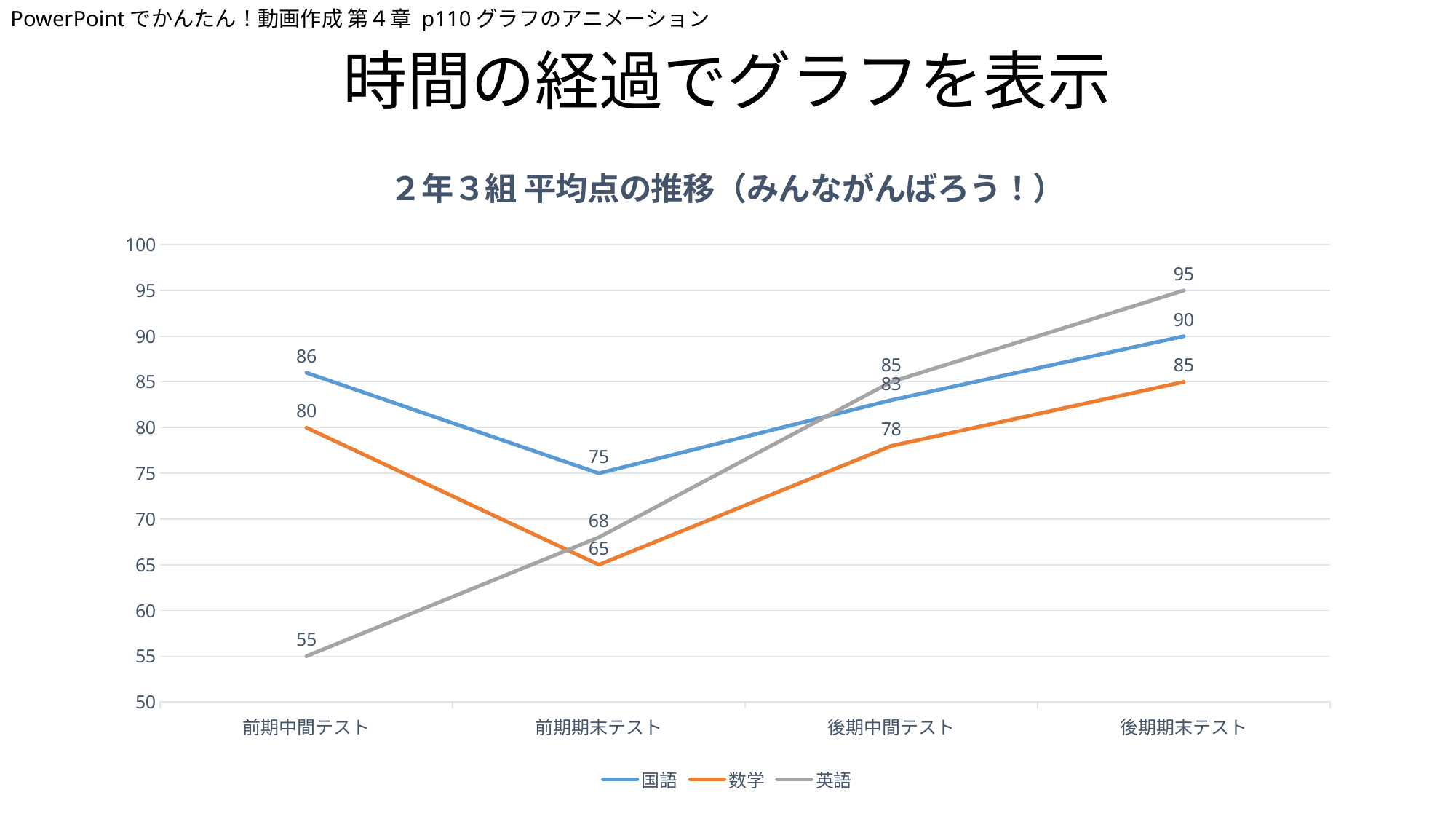
What is the value for 数学 at 前期期末テスト? 65 How many test categories are shown on the x axis? 4 Which is larger at 後期中間テスト, 英語 or 国語? 英語 What is the value for 英語 at 後期期末テスト? 95 At which test does 国語 have its lowest value? 前期期末テスト What is the value for 英語 at 前期中間テスト? 55 What is the difference between 国語 and 数学 at 後期期末テスト? 5 What kind of chart is shown on the slide? Line chart At which test does 英語 have its highest value? 後期期末テスト What is the value for 国語 at 前期中間テスト? 86 What is the difference between 英語 at 後期期末テスト and 英語 at 前期中間テスト? 40 How many series does the legend list? 3